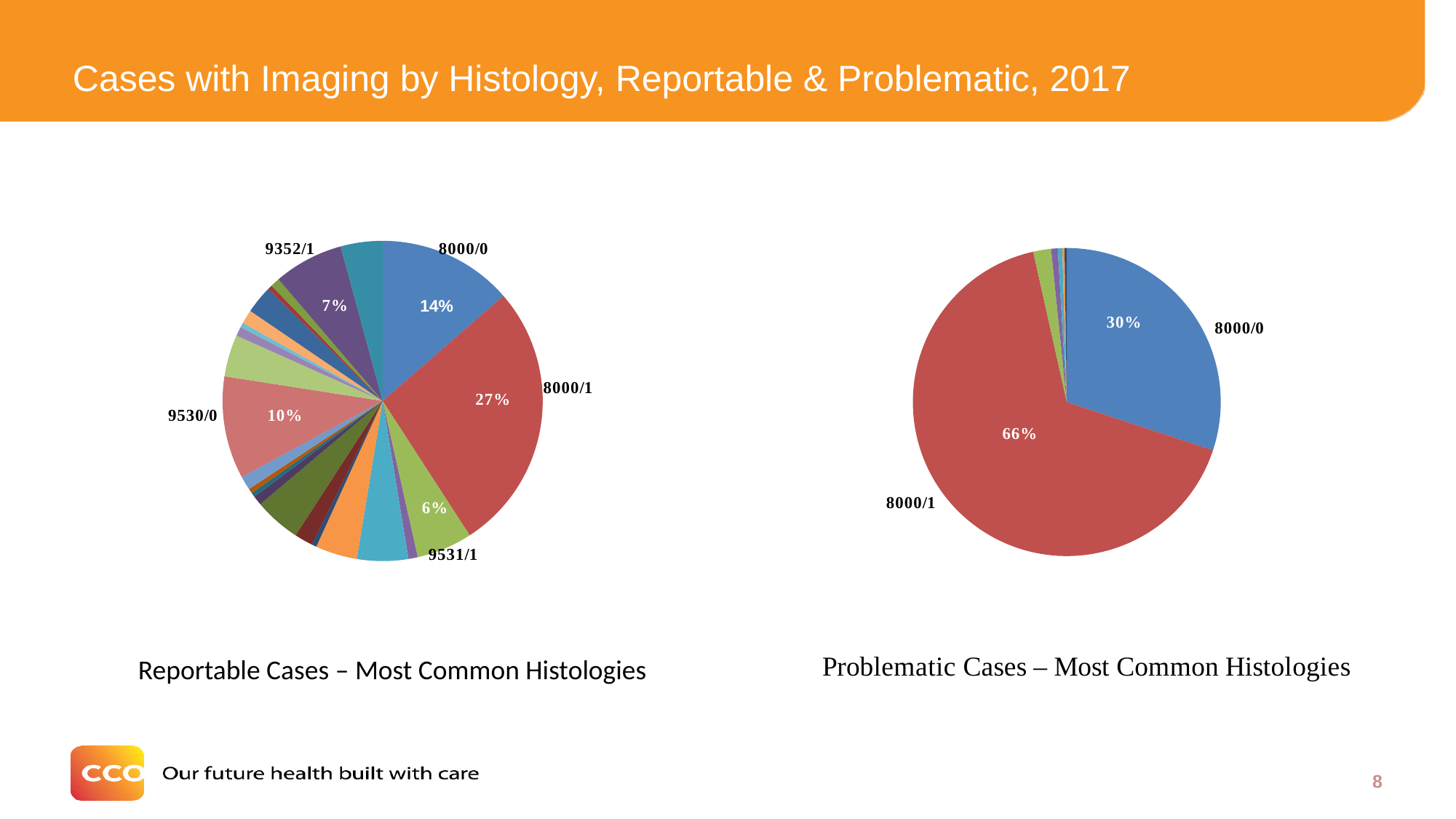
What kind of chart is used for the Problematic Cases – Most Common Histologies chart? Pie chart In the Reportable Cases – Most Common Histologies pie chart, which labelled histology has the largest share? 8000/1 In the Problematic Cases – Most Common Histologies pie chart, what share does 8000/1 have? 66% In the Reportable Cases – Most Common Histologies pie chart, what share does 9531/1 have? 6% In the Reportable Cases – Most Common Histologies pie chart, what share does 9530/0 have? 10% In the Problematic Cases – Most Common Histologies pie chart, which histology has the larger share, 8000/0 or 8000/1? 8000/1 In the Problematic Cases – Most Common Histologies pie chart, what is the difference between the shares of 8000/1 and 8000/0? 36% In the Reportable Cases – Most Common Histologies pie chart, what is the difference between the shares of 8000/1 and 8000/0? 13%